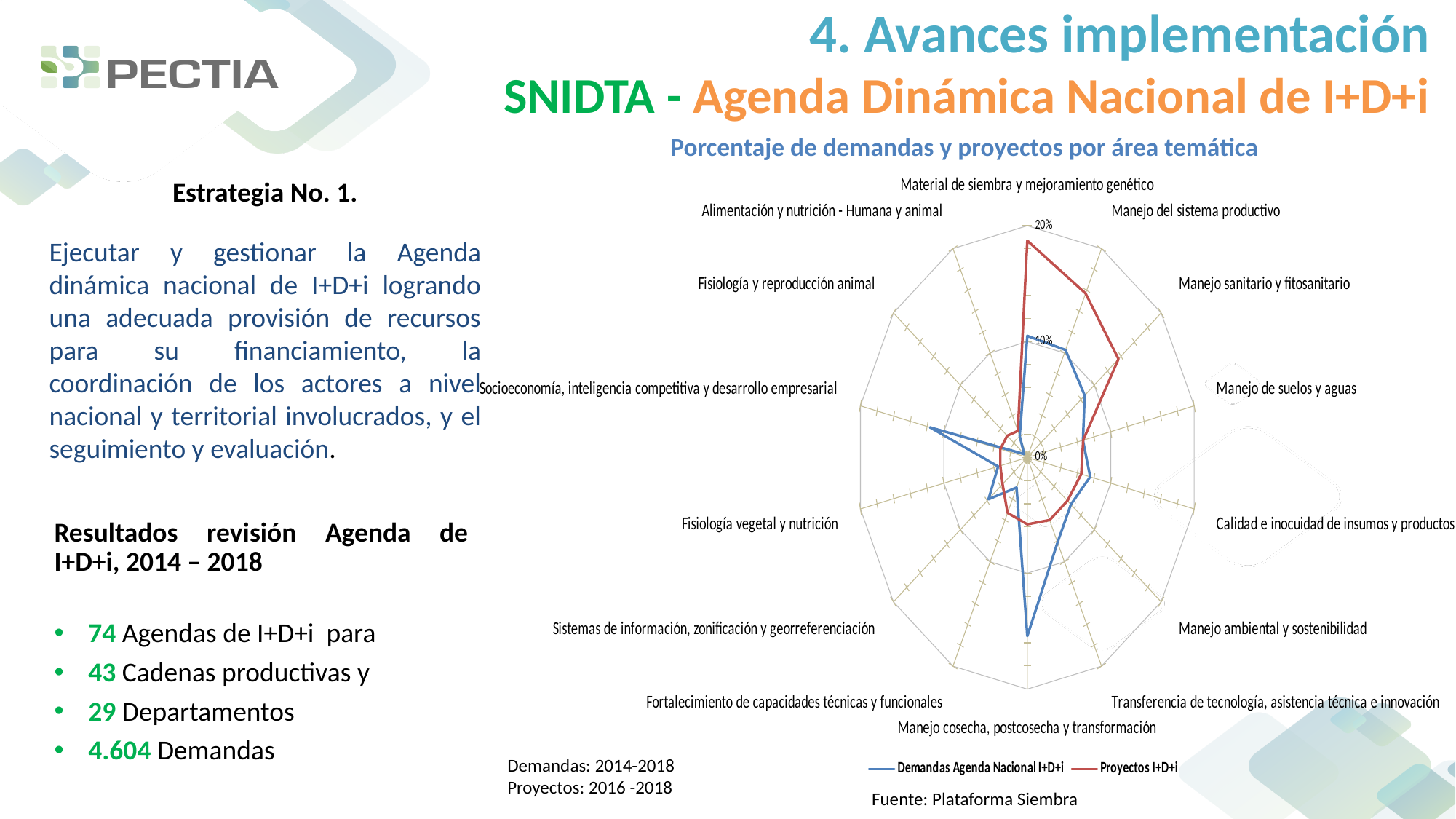
Is the value of 'Proyectos I+D+i' for 'Material de siembra y mejoramiento genético' greater or less than 10%? greater Is the value of 'Proyectos I+D+i' for 'Manejo ambiental y sostenibilidad' greater or less than 10%? less How many thematic areas (categories) are plotted on the radar chart? 14 For 'Material de siembra y mejoramiento genético', which series has the larger value: 'Demandas Agenda Nacional I+D+i' or 'Proyectos I+D+i'? Proyectos I+D+i Is the value of 'Proyectos I+D+i' for 'Manejo cosecha, postcosecha y transformación' greater or less than 10%? less How many series does the chart legend list? 2 Which colour represents the series 'Demandas Agenda Nacional I+D+i'? Blue What is the title of the chart? Porcentaje de demandas y proyectos por área temática In which thematic area does the 'Proyectos I+D+i' series reach its highest value? Material de siembra y mejoramiento genético What kind of chart is shown on the slide? Radar chart